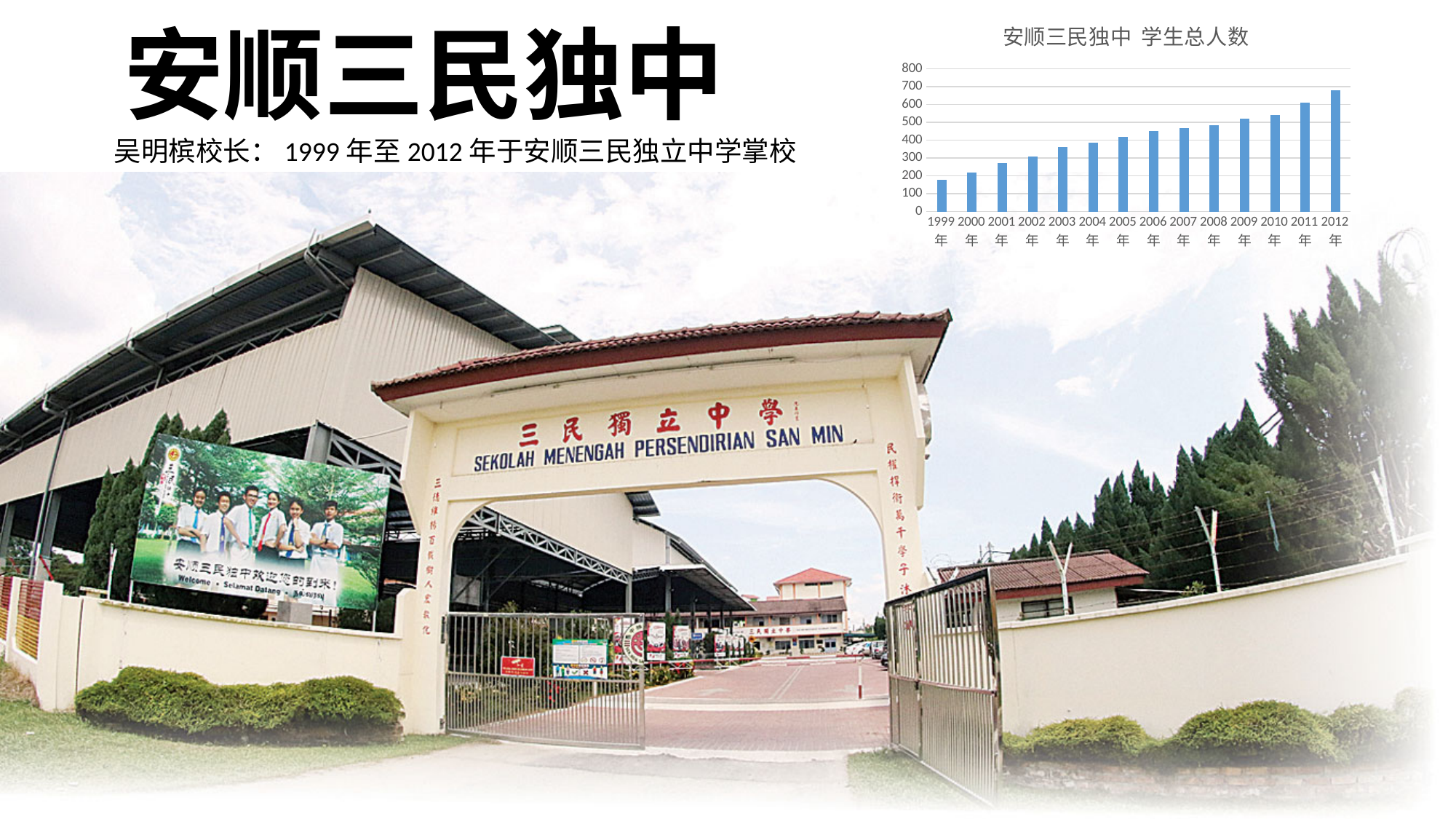
Is the value for 2005年 greater or less than 400? greater Is the value for 2002年 greater or less than 400? less Do the student totals rise or fall from 1999 to 2012? rise What is the title of the chart? 安顺三民独中 学生总人数 Which year has the highest student total in the chart? 2012年 What is the highest value shown on the vertical axis of the chart? 800 How many years (bars) are plotted in the chart? 14 What kind of chart is shown on the slide? bar chart Which is larger, the value for 2011年 or the value for 2008年? 2011年 Which year has the lowest student total in the chart? 1999年 Is the value for 2012年 greater or less than 600? greater